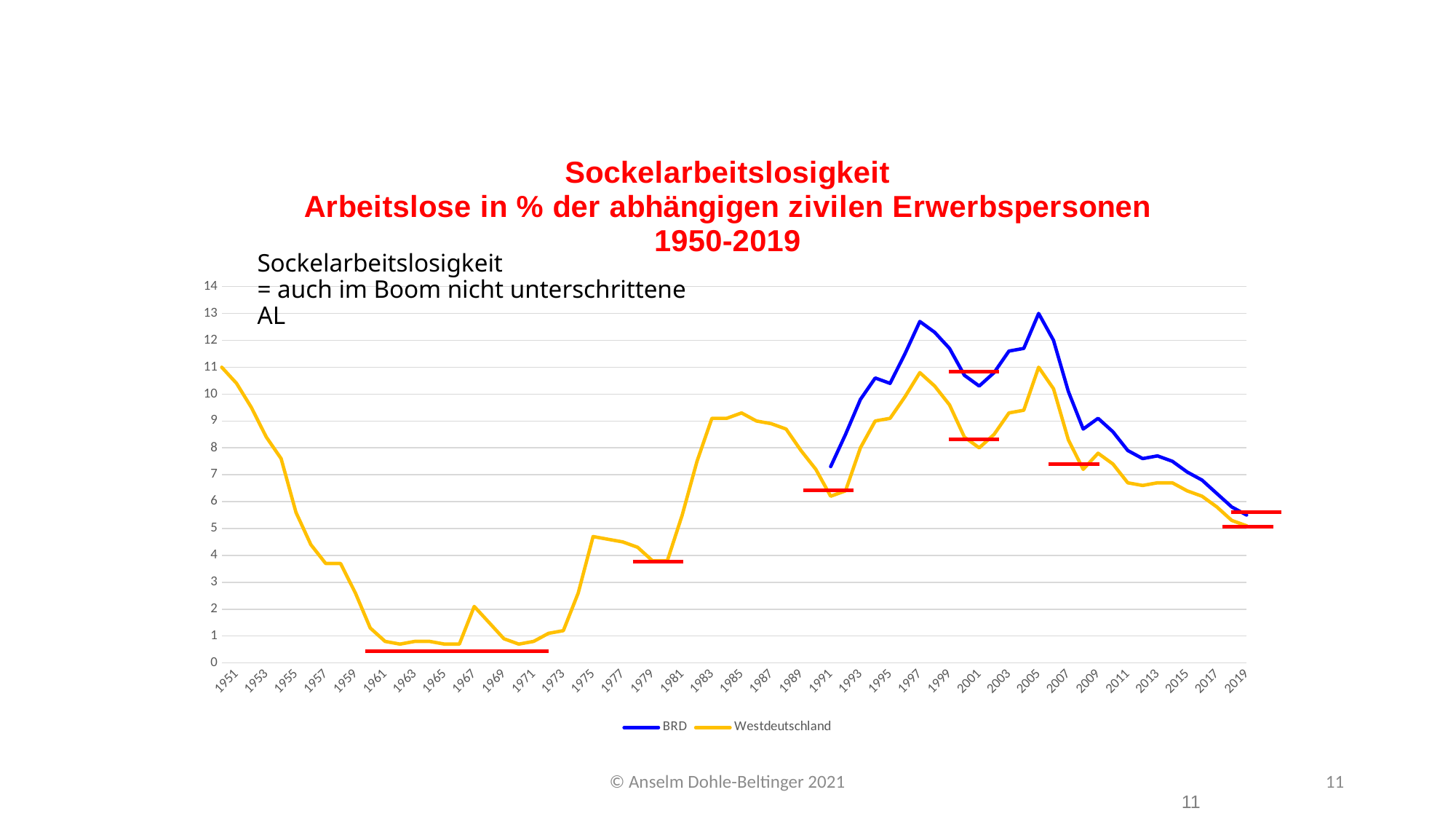
What kind of chart is shown on the slide? line chart What are the two series named in the legend? BRD and Westdeutschland Is the value for BRD in 2019 greater or less than 6? less In 2005, which series has the higher value, BRD or Westdeutschland? BRD Is the value for BRD in 2005 greater or less than 12? greater Does the BRD line rise or fall between 2005 and 2019? fall Is the value for Westdeutschland in 1955 greater or less than 7? less Does the Westdeutschland line rise or fall between 1951 and 1961? fall What colour is the BRD line? blue How many series does the legend list? 2